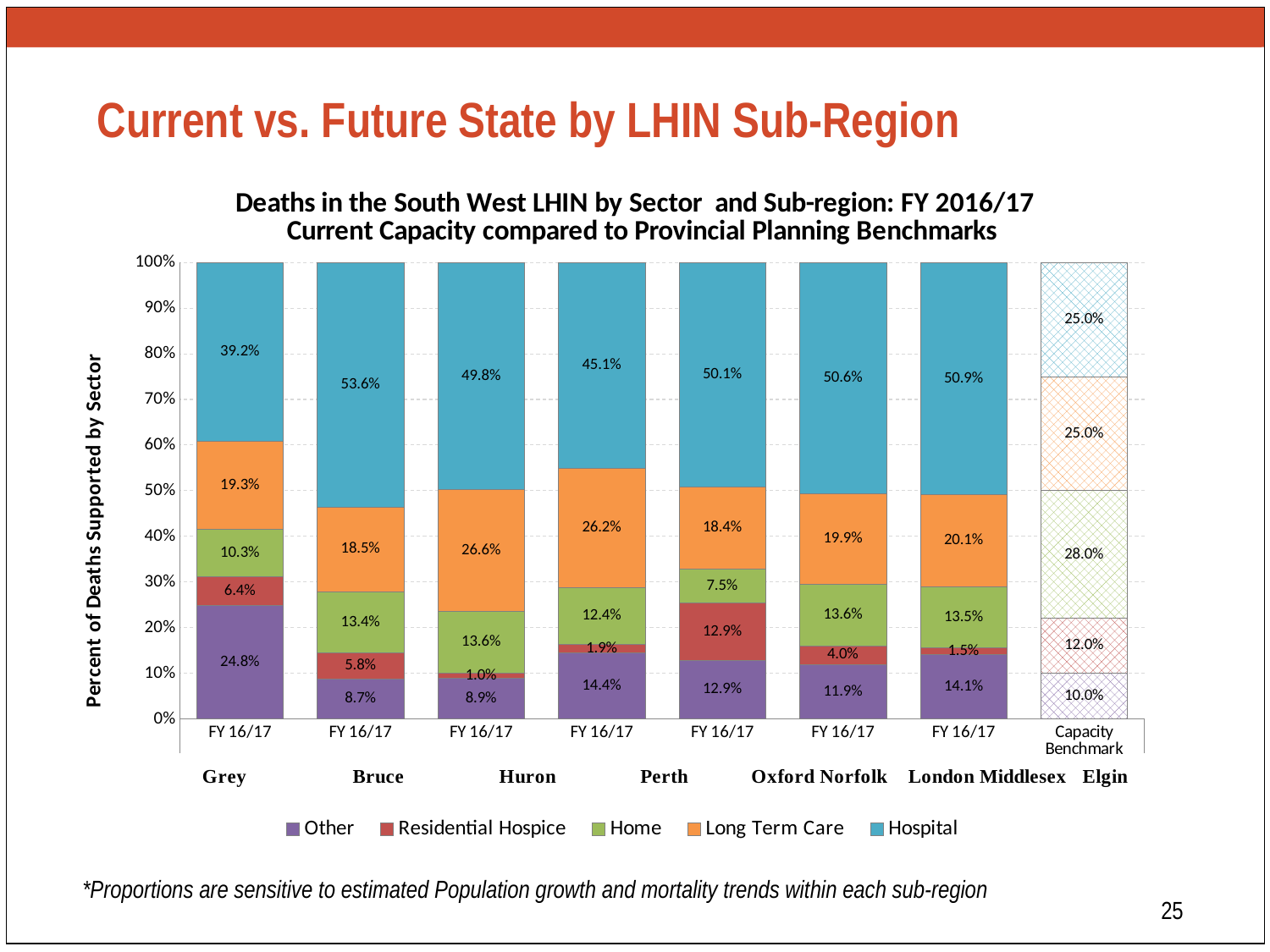
What are the five sectors listed in the legend? Other, Residential Hospice, Home, Long Term Care, Hospital What is the Residential Hospice value for Oxford Norfolk? 4.0% What kind of chart is shown on the slide? Stacked bar chart What is the Long Term Care value for Huron? 26.6% How much larger is the Other share for Grey than for Bruce? 16.1 percentage points How many series does the legend list? 5 What is the Home value in the Capacity Benchmark bar? 28.0% How many FY 16/17 bars are plotted on the chart? 7 What percentage of deaths in Grey were supported by the Hospital sector? 39.2% Which has a larger Home share, Bruce or Perth? Bruce Which sub-region has the highest Hospital share? Bruce Which sub-region has the lowest Residential Hospice share? Huron